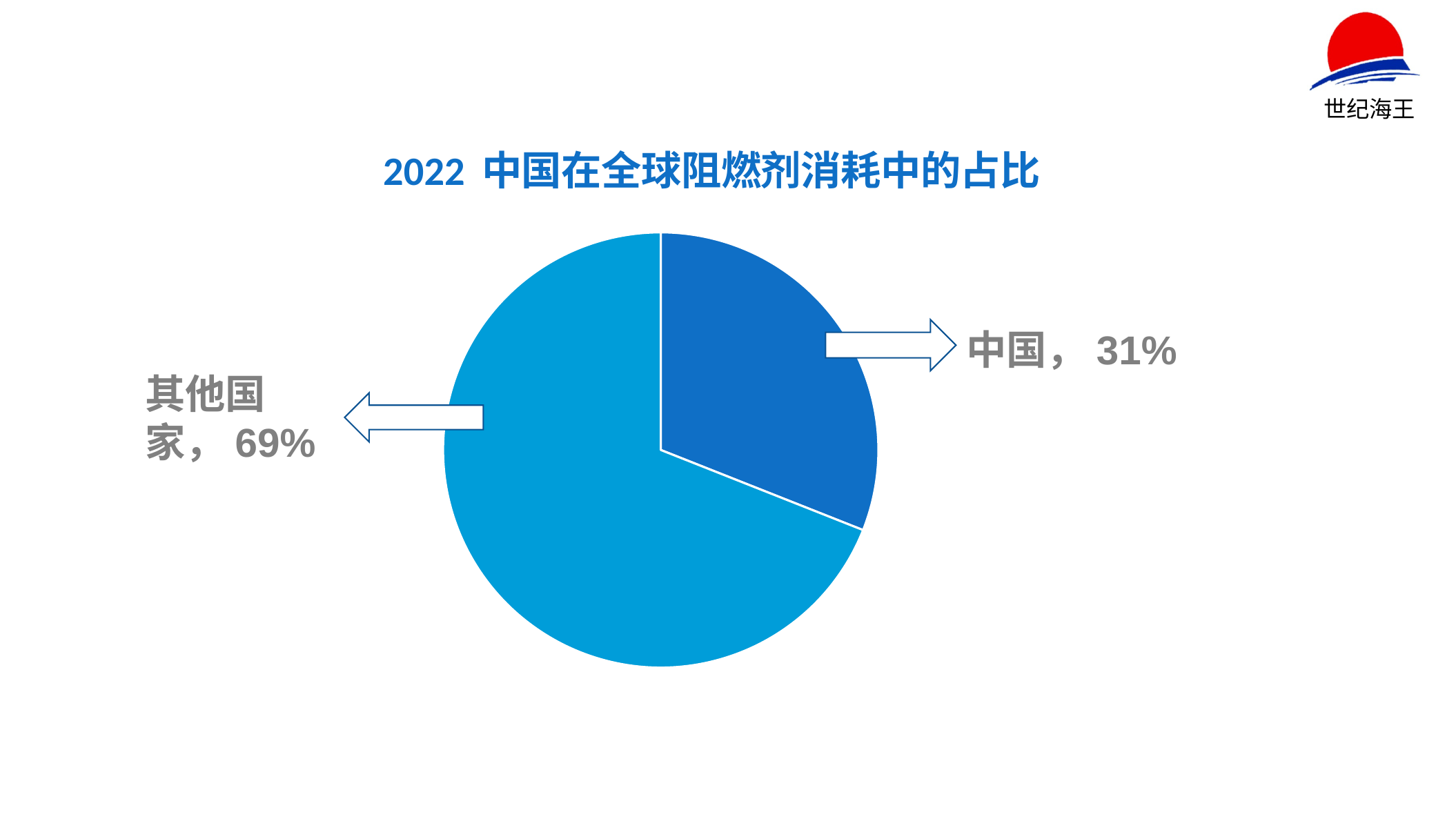
What is the difference between the share of 其他国家 and the share of 中国? 38% Which slice is the largest? 其他国家 What is the combined share of 中国 and 其他国家? 100% How many slices does the pie chart have? 2 Which slice is the smallest? 中国 Which is larger, the share of 中国 or the share of 其他国家? 其他国家 What kind of chart is shown on the slide? Pie chart What share of the pie does 中国 hold? 31% What share of the pie does 其他国家 hold? 69% Which slice is shown in the darker blue colour? 中国 What is the title of the chart? 2022 中国在全球阻燃剂消耗中的占比